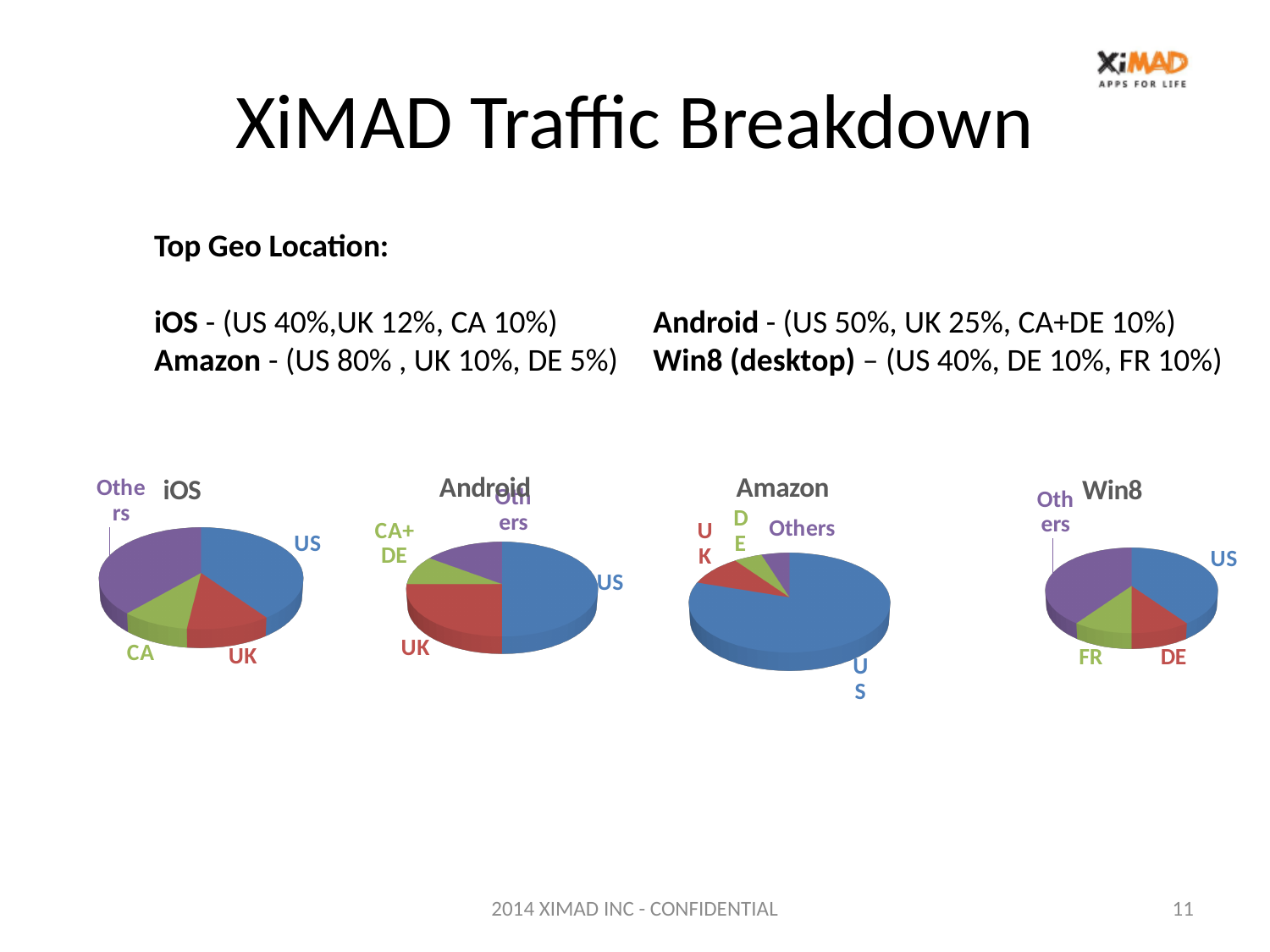
How many slices does the iOS pie chart have? 4 In the Amazon chart, what share of traffic is US? 80% In the Android chart, which slice is larger, UK or CA+DE? UK In the Amazon chart, which labelled country slice is the smallest? DE How many slices does the Win8 pie chart have? 4 In the Android chart, what share of traffic is US? 50% What kind of chart is the iOS chart? pie chart In the Win8 chart, what share of traffic is FR? 10% In the Amazon chart, which slice is the largest? US In the iOS chart, what is the difference between the US share and the UK share? 28% How many pie charts are shown on the slide? 4 In the Android chart, what is the difference between the US share and the UK share? 25%